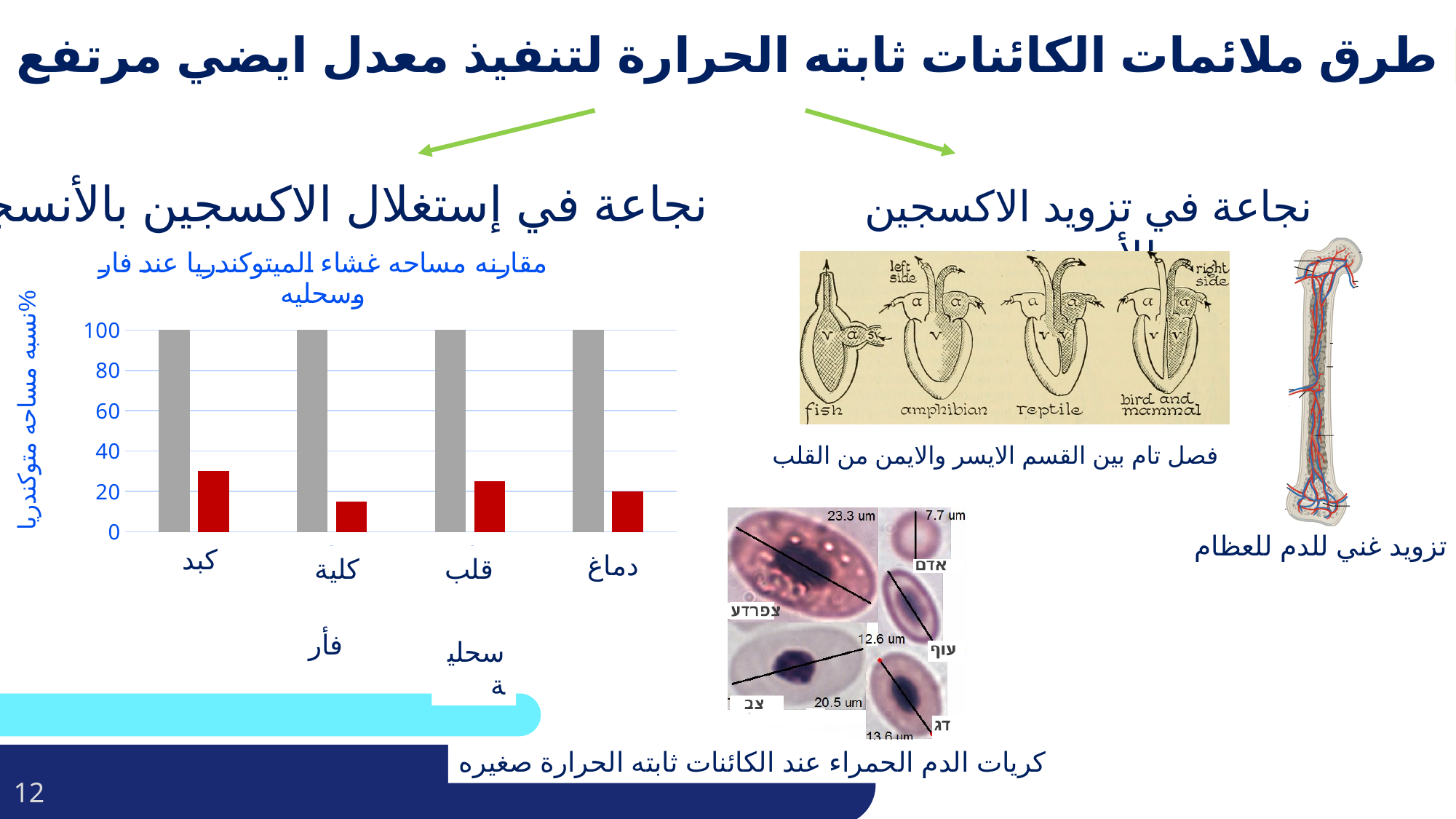
How many categories are shown on the x axis of the bar chart? 4 Which red bar is taller, كبد or قلب? كبد What is the title of the bar chart? مقارنه مساحه غشاء الميتوكندريا عند فار وسحليه What is the value of the gray bar for دماغ in the bar chart? 100 Is the value of the red bar for كبد greater or less than 20? greater What kind of chart is shown on the left of the slide? bar chart Among the red bars, which category has the lowest value? كلية What is the value of the gray bar for كبد in the bar chart? 100 How many series does the legend of the bar chart list? 2 Among the red bars, which category has the highest value? كبد Is the value of the red bar for قلب greater or less than 40? less Is the value of the red bar for كلية greater or less than 20? less